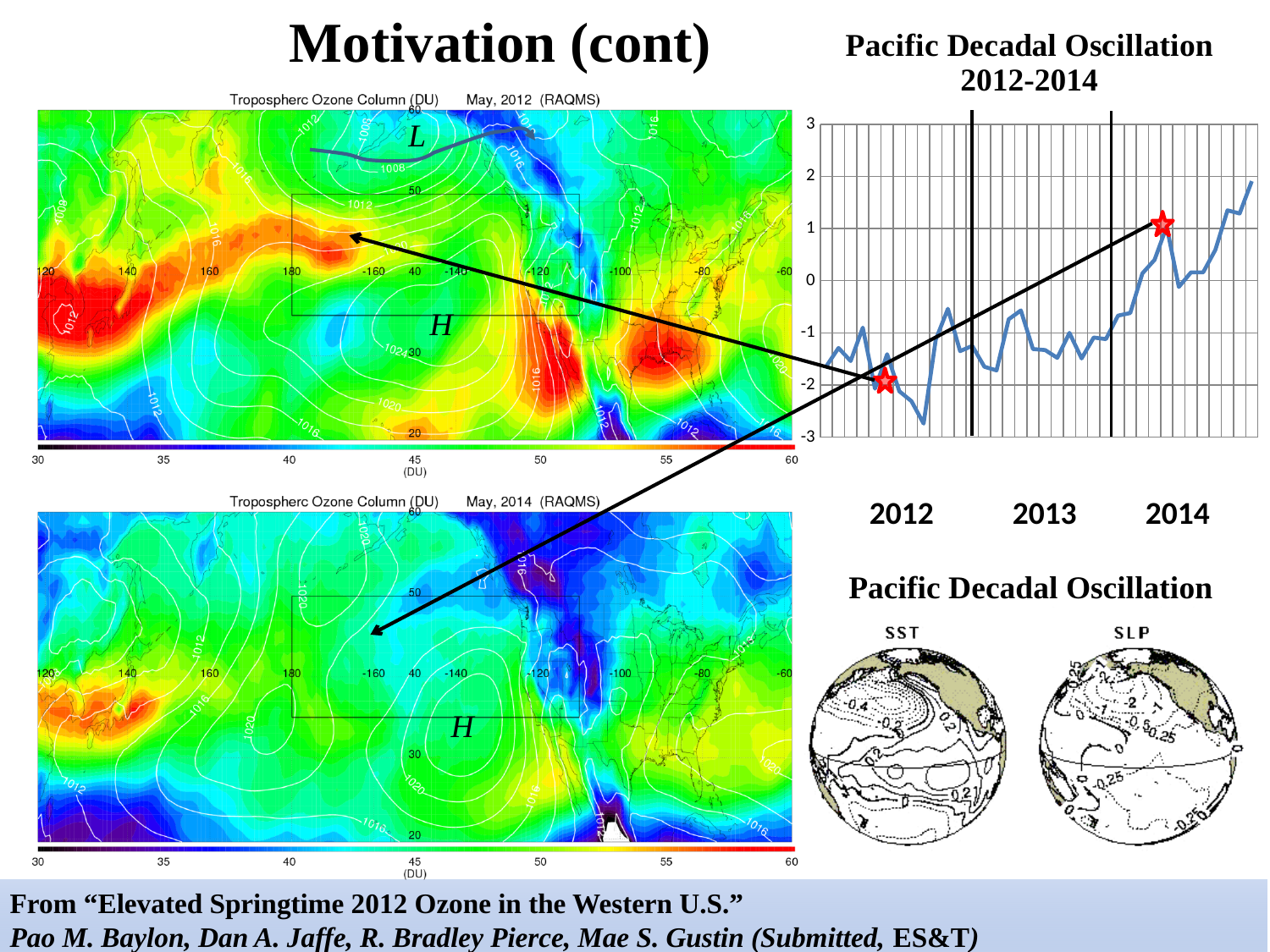
On the Pacific Decadal Oscillation 2012-2014 chart, does the line generally rise or fall from 2012 to 2014? rise On the Pacific Decadal Oscillation 2012-2014 chart, is the value at the end of 2014 greater or less than 1? greater On the Pacific Decadal Oscillation 2012-2014 chart, in which labelled year does the line reach its lowest value? 2012 What kind of chart is the Pacific Decadal Oscillation 2012-2014 chart on the right of the slide? line chart On the Pacific Decadal Oscillation 2012-2014 chart, in which labelled year does the line reach its highest value? 2014 On the Pacific Decadal Oscillation 2012-2014 chart, how many years are labelled along the x axis? 3 On the Pacific Decadal Oscillation 2012-2014 chart, is the value at the red star in 2014 greater or less than 0? greater On the Pacific Decadal Oscillation 2012-2014 chart, what is the highest value shown on the y axis? 3 On the Pacific Decadal Oscillation 2012-2014 chart, which of the two red-star points has the larger value, the one in 2012 or the one in 2014? 2014 What is the title of the line chart on the right of the slide? Pacific Decadal Oscillation 2012-2014 On the Pacific Decadal Oscillation 2012-2014 chart, is the lowest point of the line greater or less than -2? less